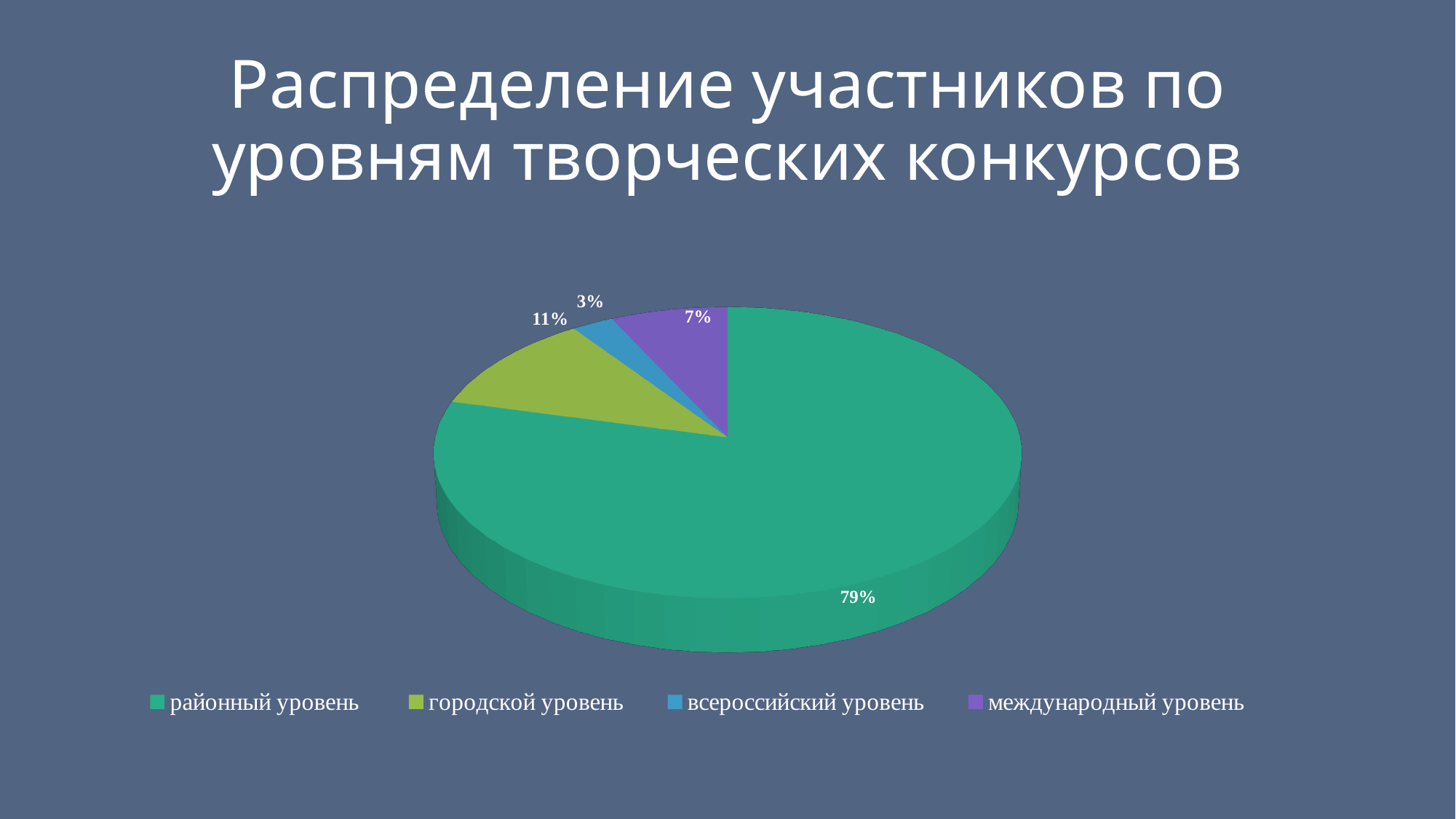
What share of participants is at the всероссийский уровень? 3% What kind of chart is shown on the slide? pie chart Which has a larger share: городской уровень or международный уровень? городской уровень Which level has the largest share of participants? районный уровень What share of participants is at the международный уровень? 7% What is the difference in percentage points between the районный уровень and the городской уровень? 68 What is the title of the chart? Распределение участников по уровням творческих конкурсов What share of participants is at the городской уровень? 11% How many categories does the pie chart show? 4 What is the difference in percentage points between the международный уровень and the всероссийский уровень? 4 Which level has the smallest share of participants? всероссийский уровень What share of participants is at the районный уровень? 79%